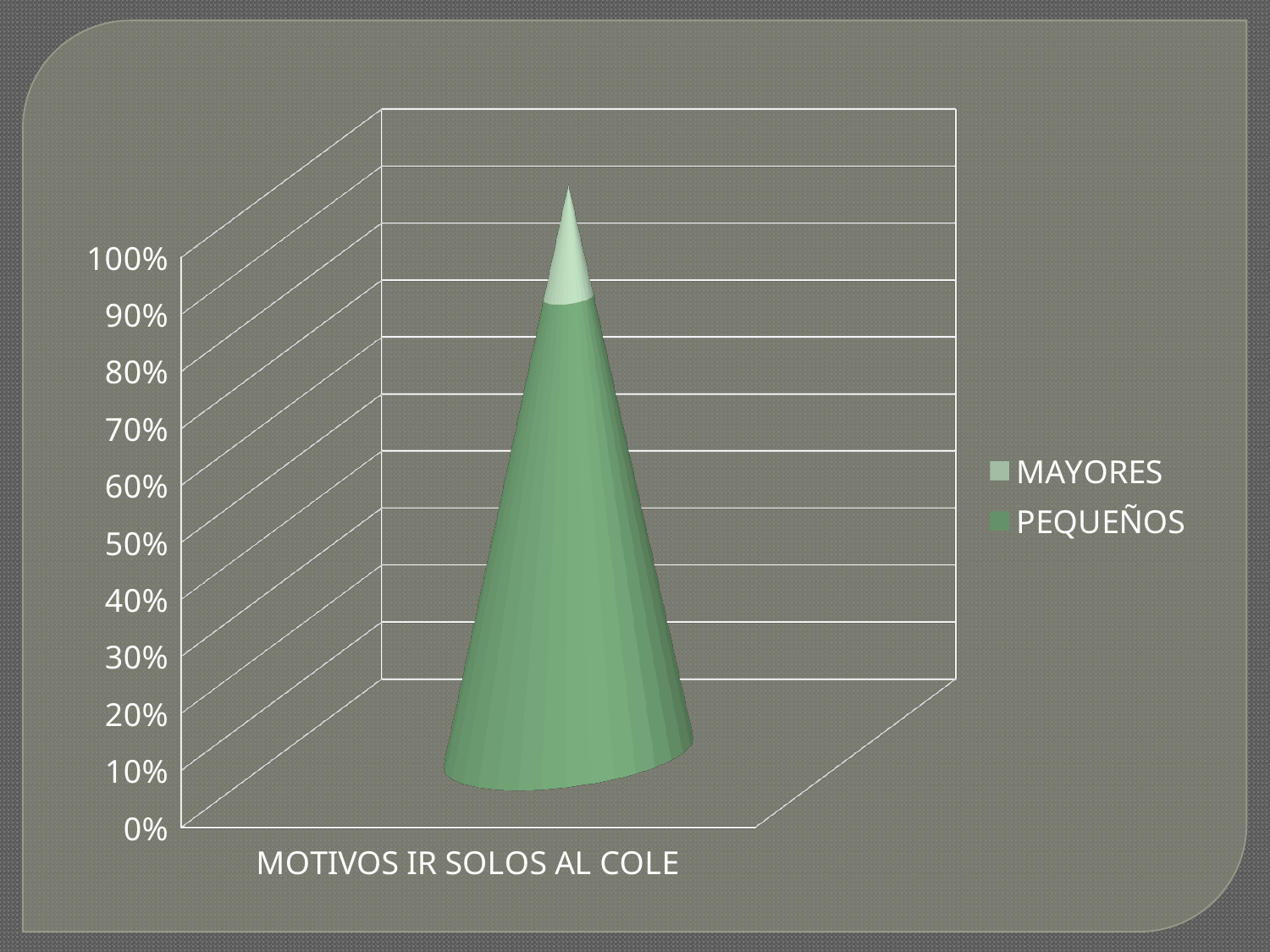
What kind of chart is shown on the slide? bar chart Is the value for PEQUEÑOS greater or less than 50%? greater How many series does the legend list? 2 Which series takes up the larger part of the stacked bar, MAYORES or PEQUEÑOS? PEQUEÑOS What is the label of the category on the x axis? MOTIVOS IR SOLOS AL COLE Which series takes up the smaller part of the stacked bar? MAYORES How many categories are shown on the x axis? 1 Is the value for MAYORES greater or less than 50%? less Which series are listed in the legend? MAYORES and PEQUEÑOS Is the value for MAYORES greater or less than 30%? less